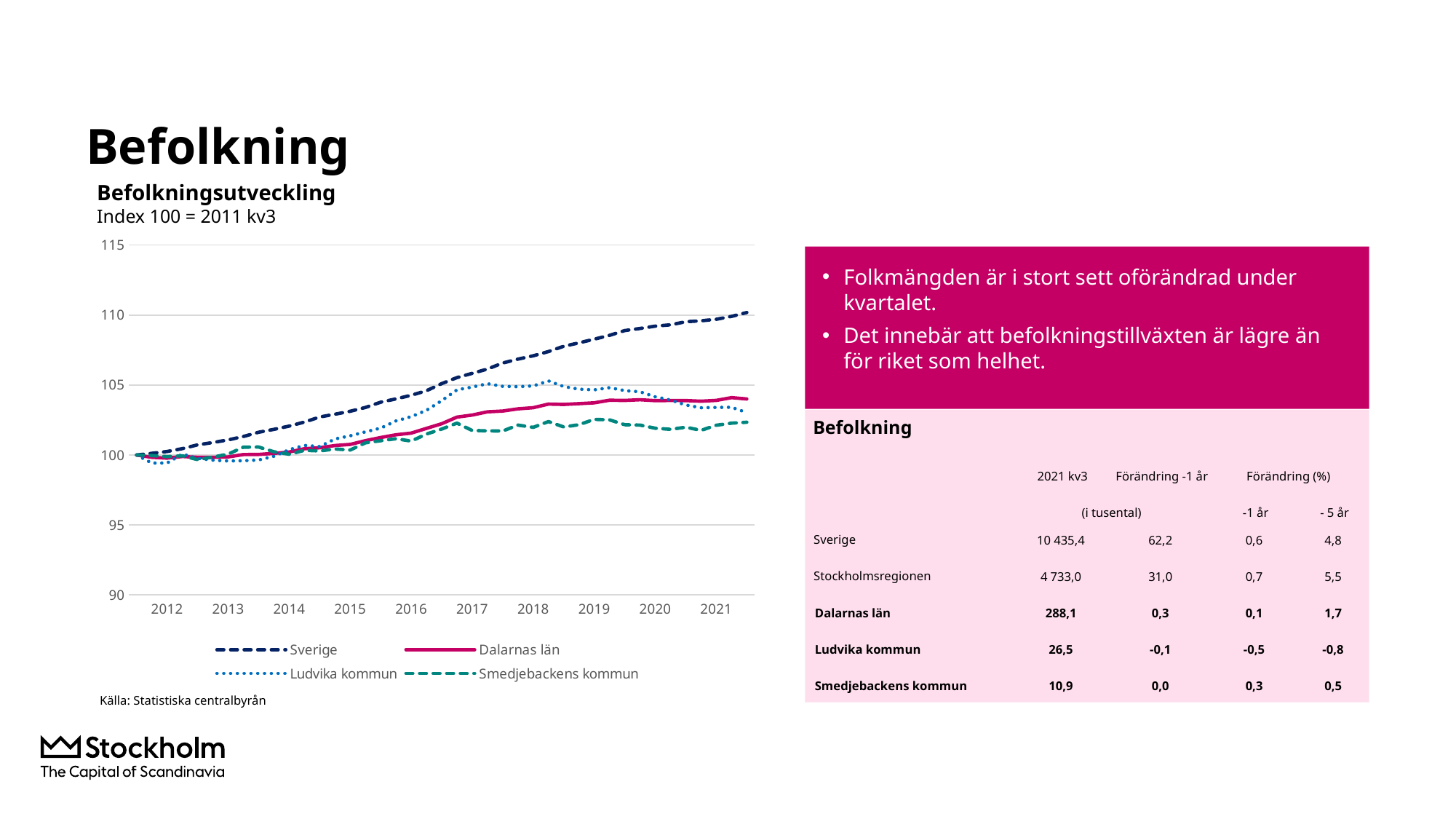
Is the value for Sverige at the end of 2021 greater or less than 105? greater Does the Sverige series rise or fall from 2012 to 2021? rise How many series does the legend of the Befolkningsutveckling chart list? 4 Is the value for Smedjebackens kommun at the end of 2021 greater or less than 100? greater Which series has the lowest value at the end of the chart in 2021? Smedjebackens kommun Which series has the highest value at the end of the chart in 2021? Sverige What kind of chart is shown under the heading Befolkningsutveckling? line chart How many year labels are shown on the x axis of the chart? 10 What is the title of the chart on the slide? Befolkningsutveckling Around 2018, which series is higher: Ludvika kommun or Smedjebackens kommun? Ludvika kommun What base period is the index in the chart set to 100 for? 2011 kv3 Is the value for Dalarnas län at the end of 2021 greater or less than 105? less